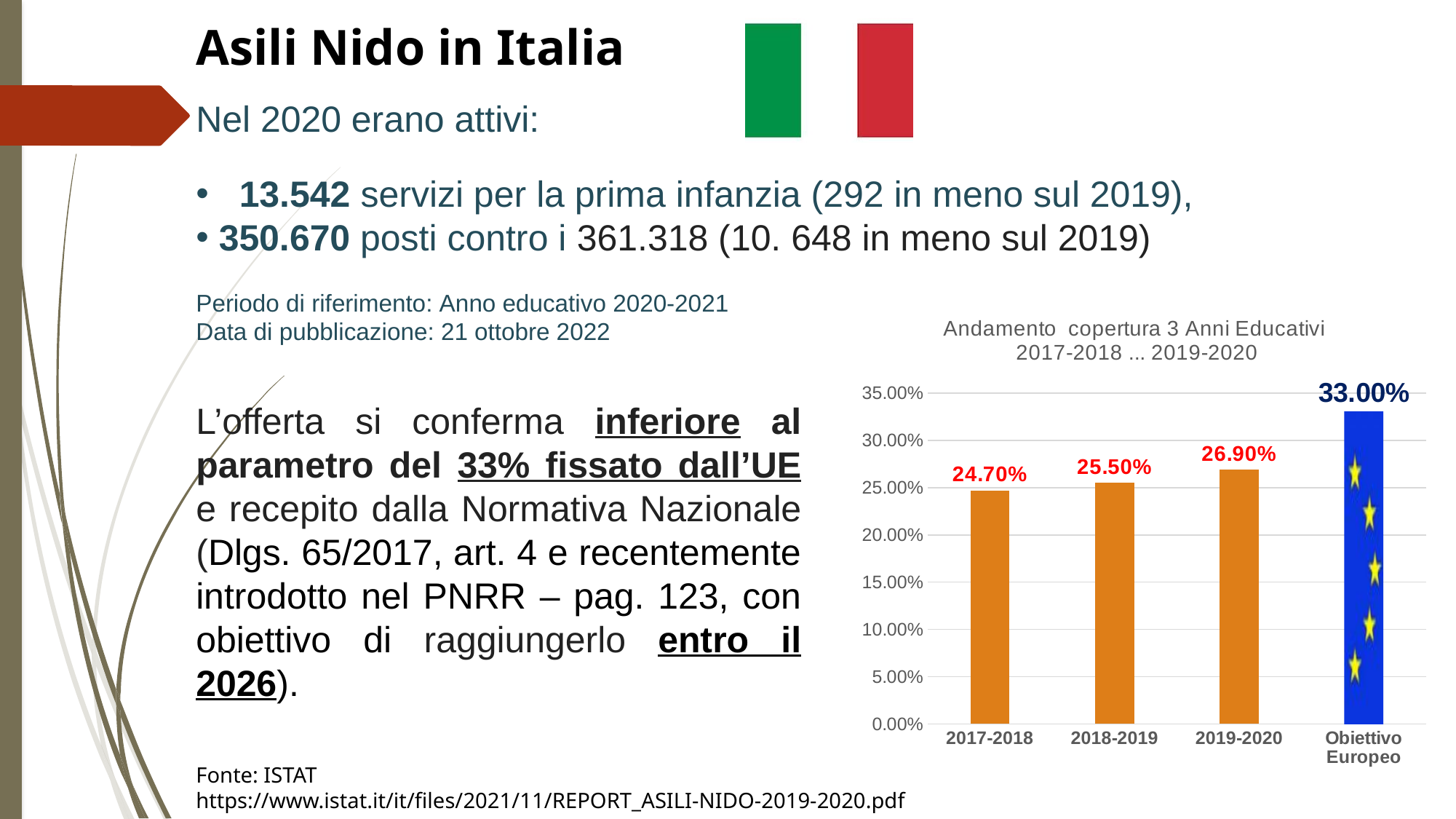
Which is larger, the value for 2018-2019 or the value for 2019-2020? 2019-2020 What kind of chart is shown on the slide? Bar chart Which category has the highest value? Obiettivo Europeo What is the value for 2019-2020? 26.90% What is the value for 2017-2018? 24.70% Which category has the lowest value? 2017-2018 How many bars are shown in the chart? 4 What is the value for Obiettivo Europeo? 33.00% Do the values rise or fall from 2017-2018 to 2019-2020? Rise What is the difference between the 2019-2020 value and the 2017-2018 value? 2.20% What is the difference between the Obiettivo Europeo value and the 2019-2020 value? 6.10% What is the value for 2018-2019? 25.50%